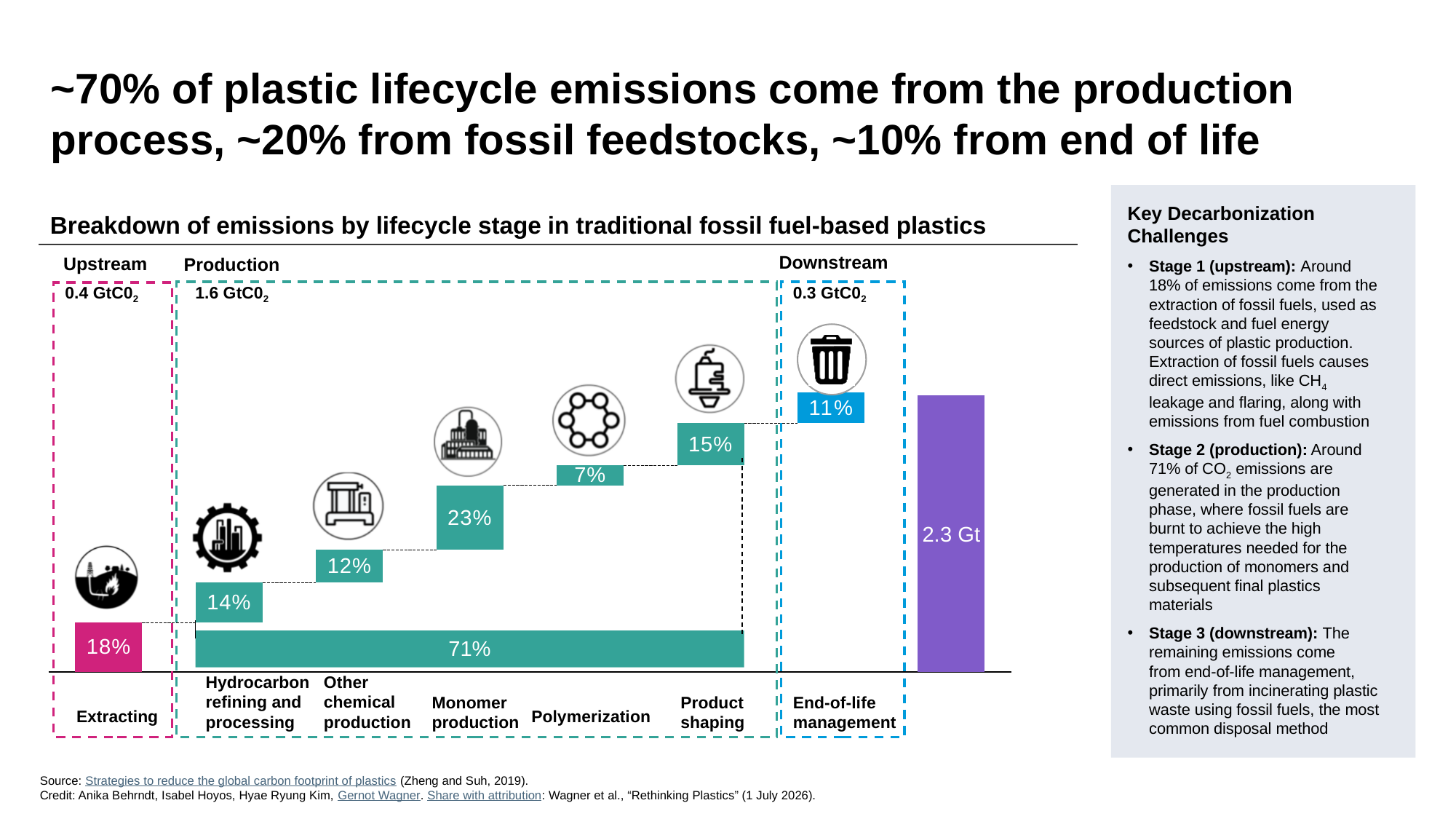
What percentage of emissions comes from Monomer production? 23% What is the difference in percentage points between Monomer production and Polymerization? 16 percentage points What share of emissions does the Production phase account for in total? 71% What percentage of emissions comes from the Extracting stage? 18% Which has a larger share of emissions, Product shaping or Hydrocarbon refining and processing? Product shaping How many GtCO2 of emissions are attributed to the Upstream phase? 0.4 GtCO2 What kind of chart is shown on the slide? Waterfall chart What is the title of the chart? Breakdown of emissions by lifecycle stage in traditional fossil fuel-based plastics Which lifecycle stage has the highest share of emissions? Monomer production Which lifecycle stage has the lowest share of emissions? Polymerization What is the total emissions value shown by the final bar? 2.3 Gt How many individual lifecycle stages are shown along the x axis? 7